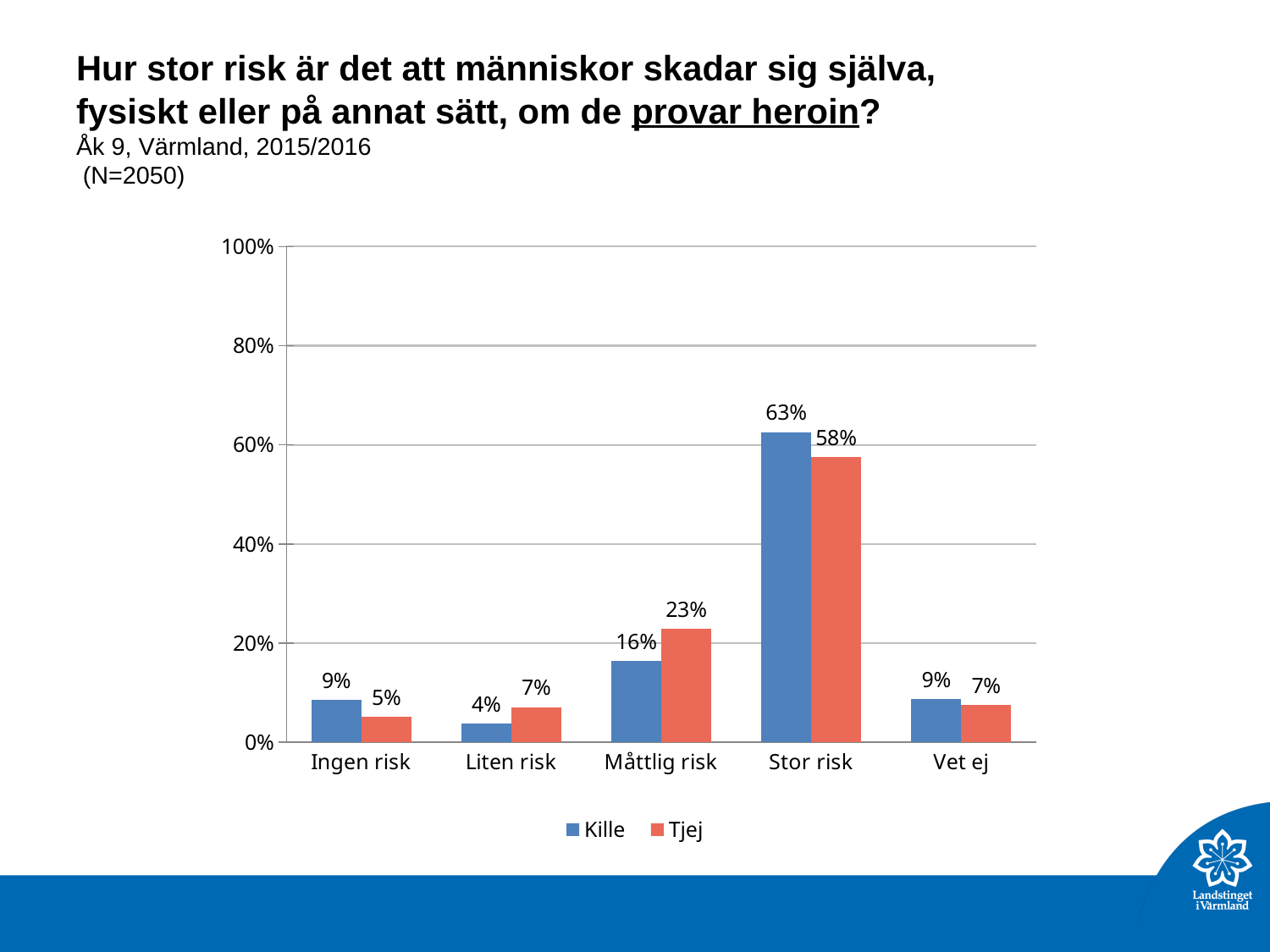
How many series does the legend list? 2 What is the value for Tjej in the Måttlig risk category? 23% Which is larger in the Liten risk category, Kille or Tjej? Tjej Which category has the highest value for Kille? Stor risk What kind of chart is shown on the slide? Bar chart What is the difference between Kille and Tjej in the Stor risk category? 5% How many categories are shown on the x axis? 5 What is the difference between Tjej and Kille in the Måttlig risk category? 7% What is the value for Kille in the Stor risk category? 63% What is the value for Tjej in the Ingen risk category? 5% Which category has the lowest value for Kille? Liten risk Is the value for Tjej in the Stor risk category greater or less than 40%? greater